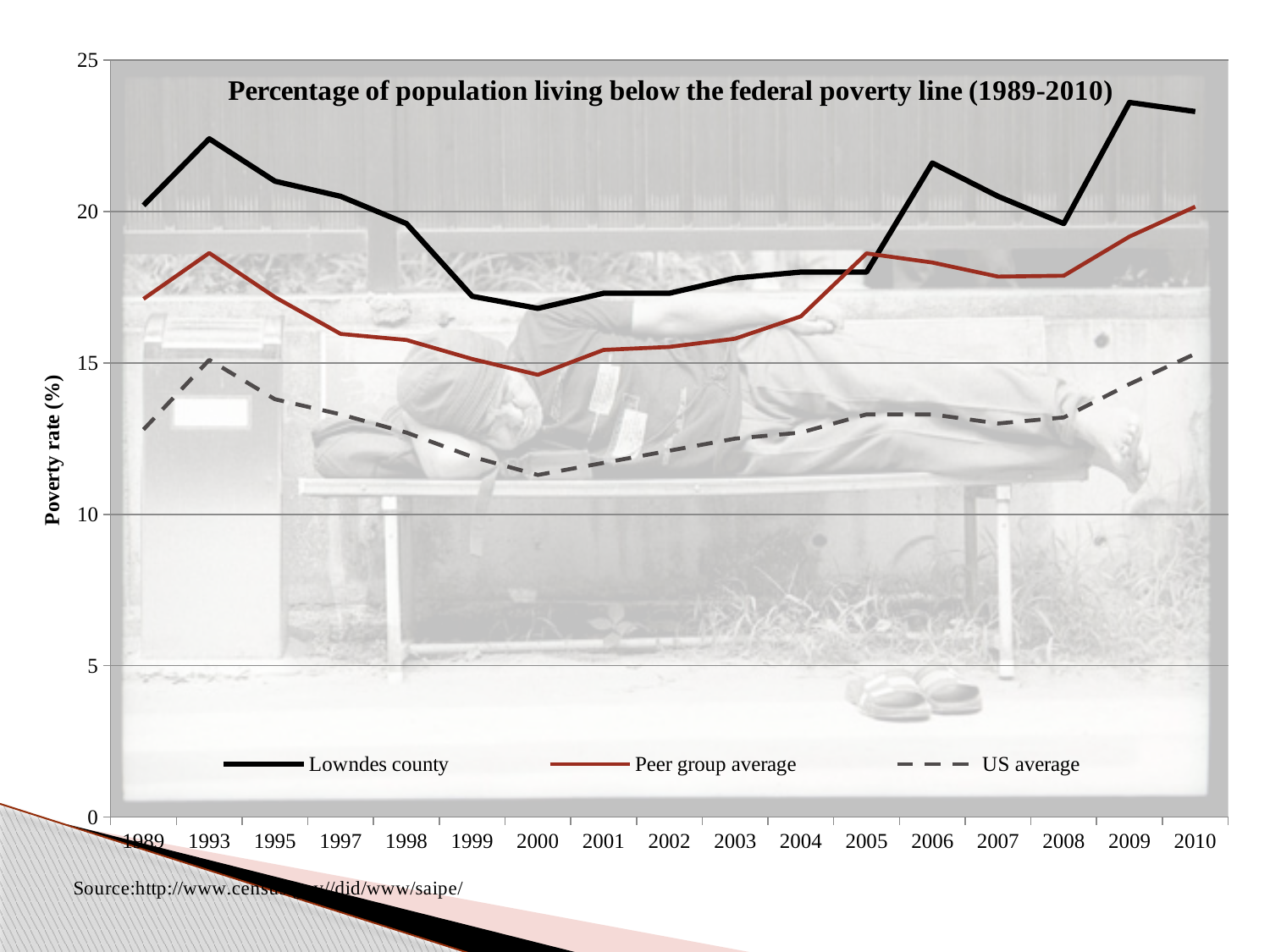
Does the US average rise or fall from 1993 to 2000? fall Is the value for Lowndes county in 2009 greater or less than 20? greater What is the title of the chart? Percentage of population living below the federal poverty line (1989-2010) What kind of chart is shown on the slide? line chart In which year is the Peer group average highest? 2010 How many years are shown along the x axis? 17 Is the value for US average in 2000 greater or less than 15? less Is the value for Peer group average in 1989 greater or less than 15? greater In 1993, which is larger: Lowndes county or Peer group average? Lowndes county How many series does the legend list? 3 Which series is drawn with a dashed line? US average